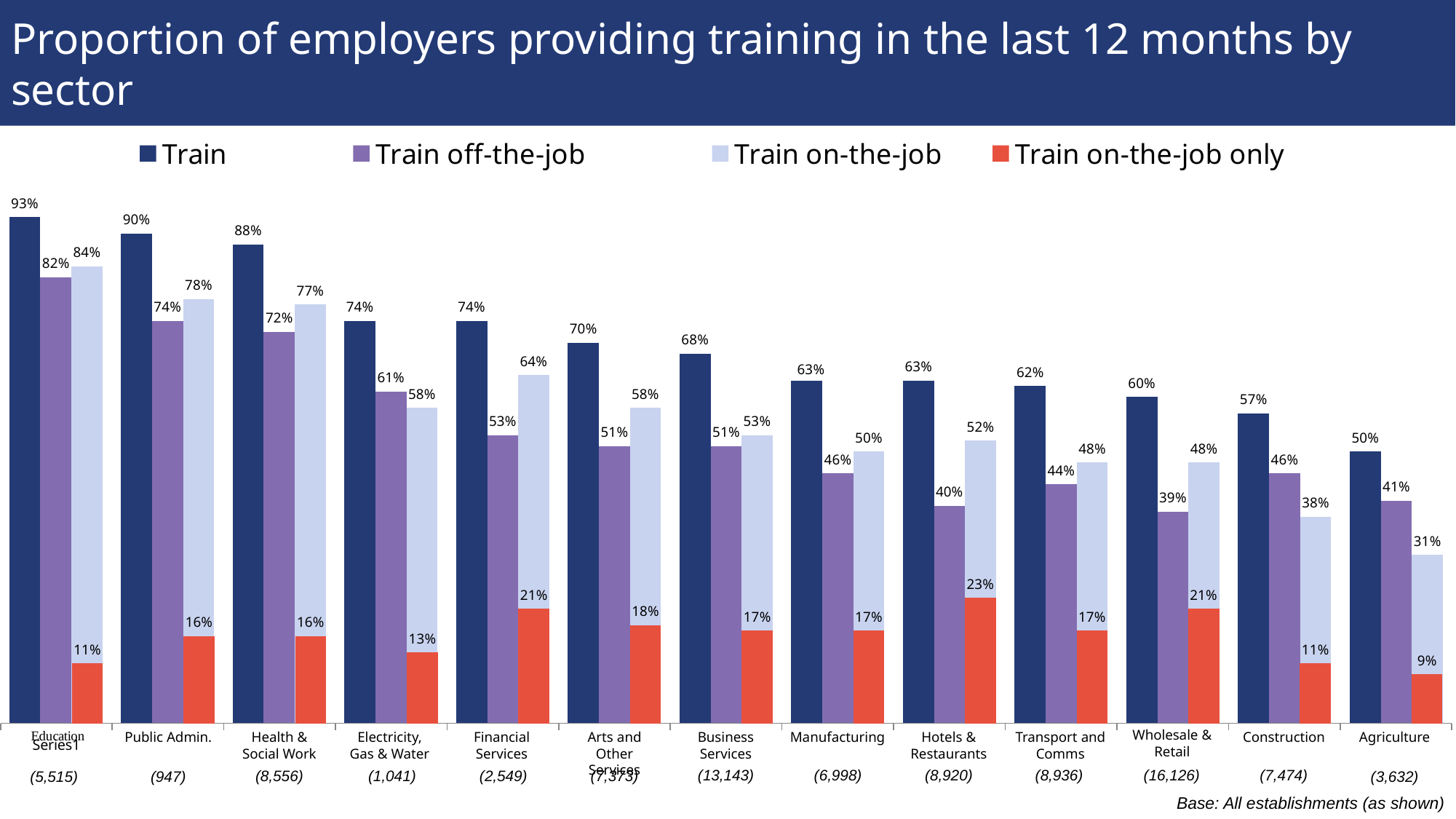
What is the value for Train on-the-job in Financial Services? 64% What is the difference between the Train value for Education and the Train value for Agriculture? 43% What kind of chart is shown on the slide? Bar chart How many sectors are shown on the x axis? 13 What is the value for Train off-the-job in Wholesale & Retail? 39% How many series does the legend list? 4 Which is larger in Construction: Train off-the-job or Train on-the-job? Train off-the-job Do the Train values rise or fall moving from left to right along the x axis? Fall Which sector has the highest value for Train on-the-job only? Hotels & Restaurants What is the value for Train on-the-job only in Hotels & Restaurants? 23% Which sector has the lowest value for Train? Agriculture What is the value for Train in the Education sector? 93%